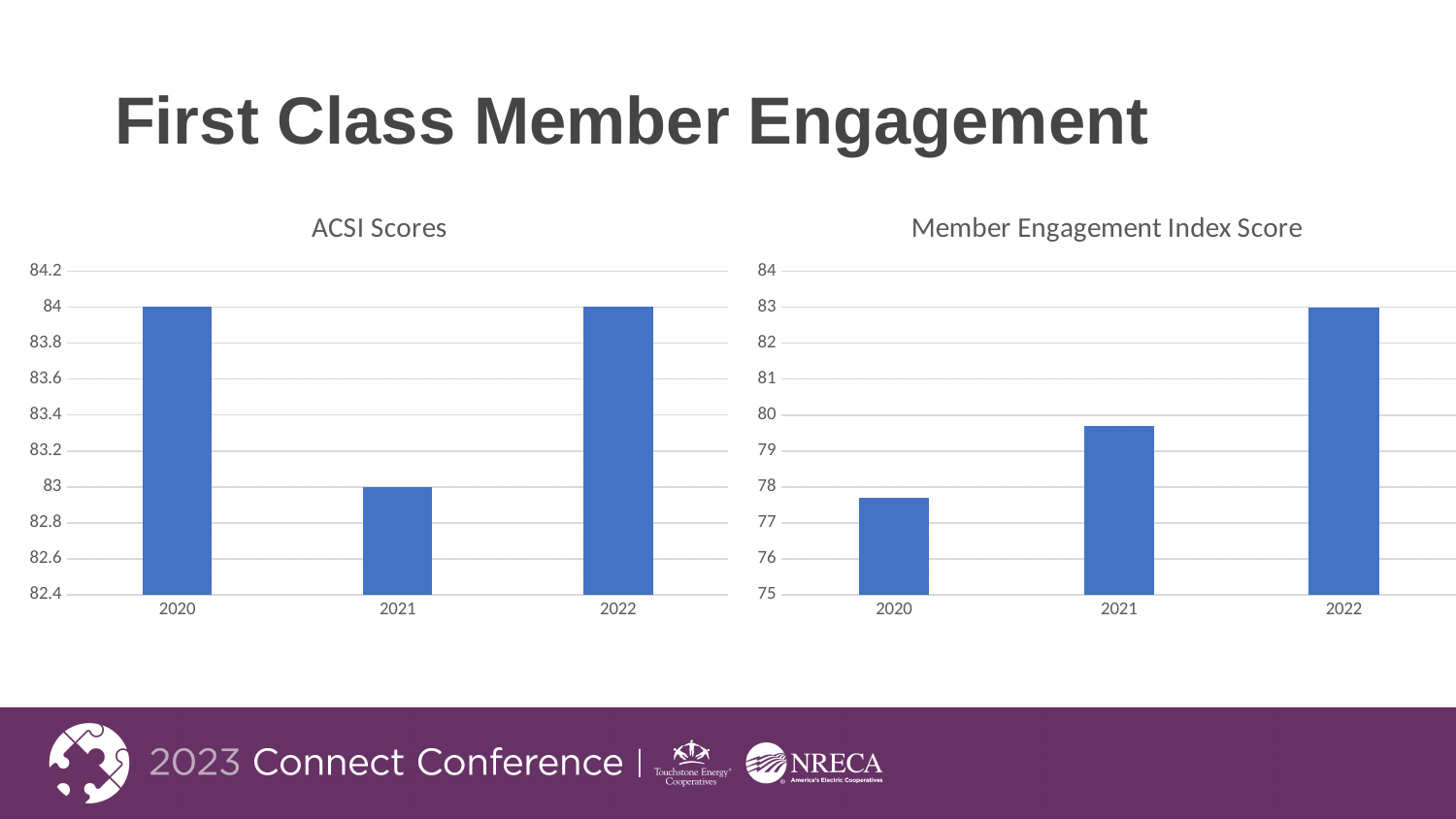
In the ACSI Scores chart, which year has the lowest value? 2021 In the Member Engagement Index Score chart, which year has the highest value? 2022 In the ACSI Scores chart, what is the value for 2020? 84 In the Member Engagement Index Score chart, what is the value for 2022? 83 How many years are shown in the ACSI Scores chart? 3 In the Member Engagement Index Score chart, is the value for 2021 greater or less than 80? less In the Member Engagement Index Score chart, is the value for 2020 greater or less than 78? less In the ACSI Scores chart, what is the difference between the 2020 and 2021 values? 1 In the Member Engagement Index Score chart, which is larger, the value for 2021 or the value for 2020? 2021 What kind of chart is the Member Engagement Index Score chart? bar chart In the ACSI Scores chart, what is the value for 2021? 83 In the Member Engagement Index Score chart, which year has the lowest value? 2020